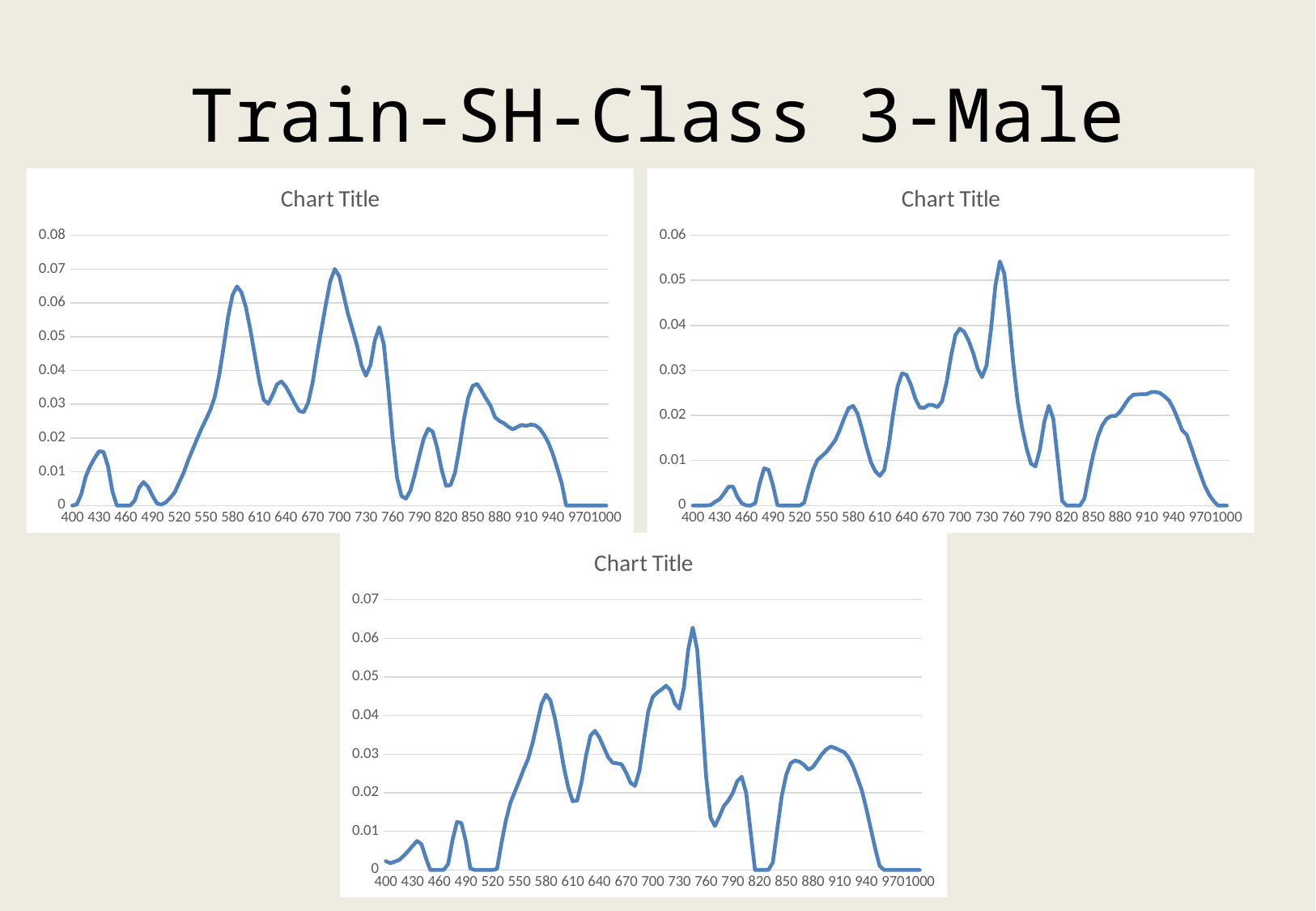
In the top-right chart, is the value at 700 greater or less than 0.03? greater In the bottom chart, is the value at 580 greater or less than 0.04? greater How many charts are shown on the slide? 3 In the bottom chart, is the value at 520 greater or less than 0.01? less What is the highest value shown on the y axis of the top-left chart? 0.08 In the top-left chart, which is larger, the value at 430 or the value at 490? 430 What kind of chart is the top-left chart? line chart What title is shown above each of the three charts? Chart Title In the top-right chart, which is larger, the value at 580 or the value at 700? 700